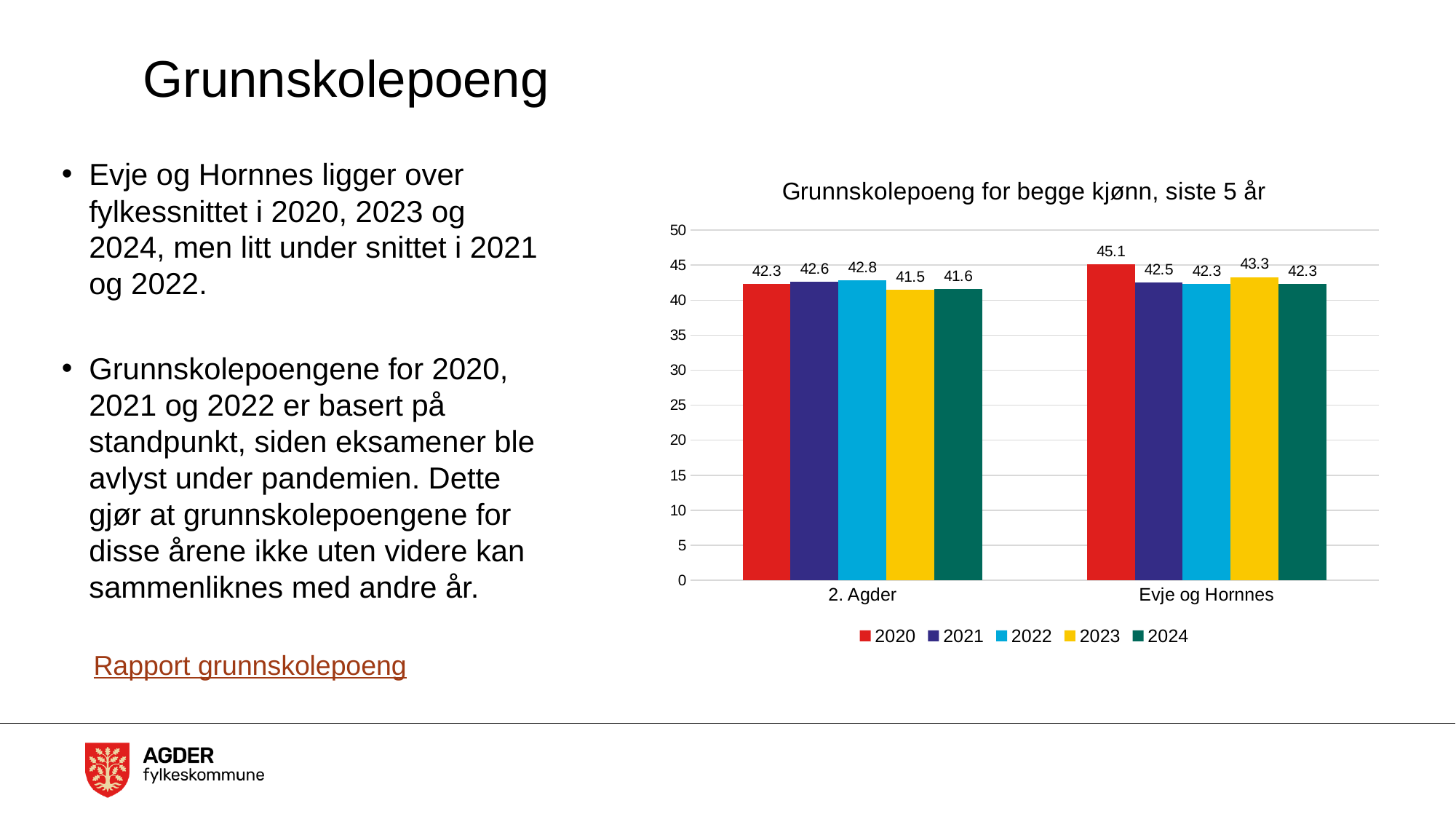
What is the value for Evje og Hornnes in 2020? 45.1 What kind of chart is shown? Bar chart What is the value for 2. Agder in 2023? 41.5 What is the value for 2. Agder in 2020? 42.3 How many series does the legend list? 5 How many categories are shown on the x axis? 2 Which is larger in 2021: 2. Agder or Evje og Hornnes? 2. Agder What is the value for Evje og Hornnes in 2023? 43.3 Which year has the lowest value for 2. Agder? 2023 What is the difference between Evje og Hornnes and 2. Agder in 2020? 2.8 What is the title of the chart? Grunnskolepoeng for begge kjønn, siste 5 år Which year has the highest value for Evje og Hornnes? 2020